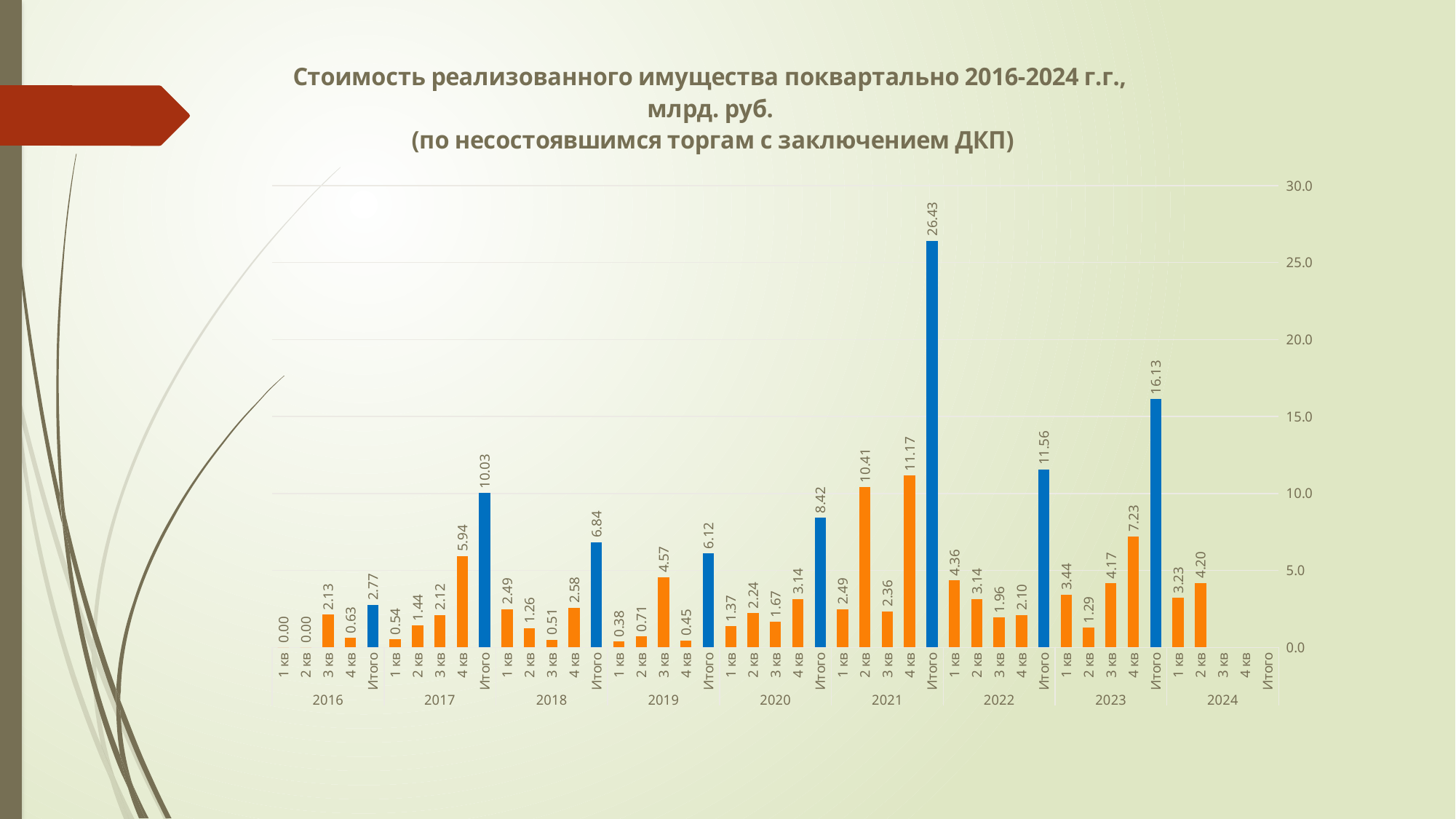
What is the value for 2 кв of 2024? 4.20 What is the value for 3 кв of 2019? 4.57 What is the value of the "Итого" bar for 2021? 26.43 Which is larger: the value for 2 кв of 2021 or the value for 4 кв of 2021? 4 кв of 2021 Which year has the lowest "Итого" bar? 2016 What is the value for 4 кв of 2023? 7.23 What type of chart is shown on the slide? Bar chart Do the "Итого" values rise or fall from 2016 to 2017? Rise Is the "Итого" value for 2017 greater or less than 5.0? greater Which year has the highest "Итого" bar? 2021 What is the difference between the "Итого" values for 2023 and 2022? 4.57 What colour are the "Итого" bars in the chart? Blue